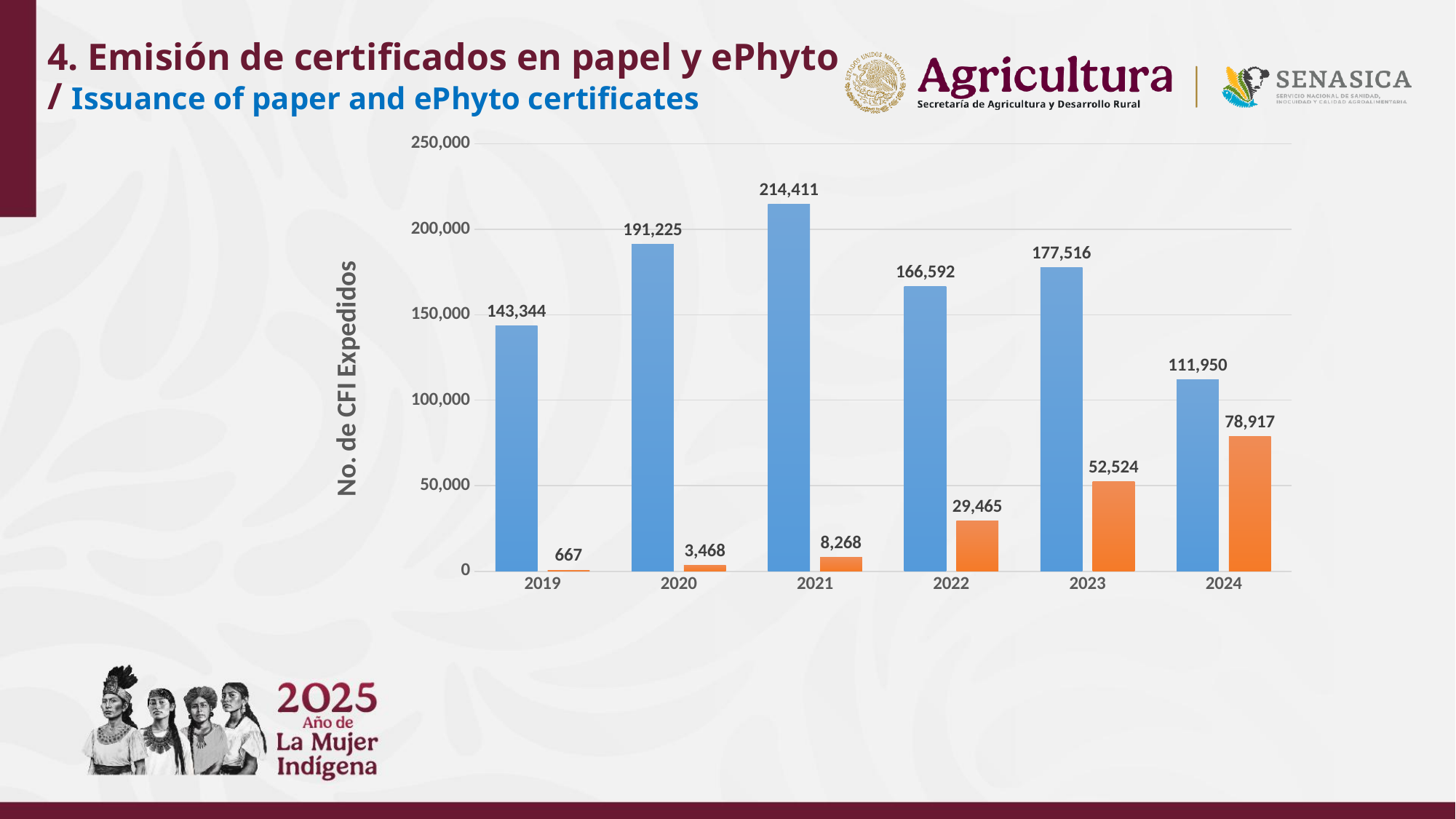
What is the difference between the blue bar values for 2021 and 2020? 23,186 What kind of chart is shown on the slide? Bar chart What is the difference between the blue and orange bar values in 2024? 33,033 In which year is the blue bar lowest? 2024 Do the orange bar values rise or fall from 2019 to 2024? Rise How many years are shown on the x axis? 6 What is the value of the orange bar for 2019? 667 Which is larger, the blue bar for 2022 or the blue bar for 2023? 2023 What is the value of the blue bar for 2021? 214,411 What is the value of the orange bar for 2024? 78,917 In which year is the orange bar highest? 2024 In which year is the blue bar highest? 2021